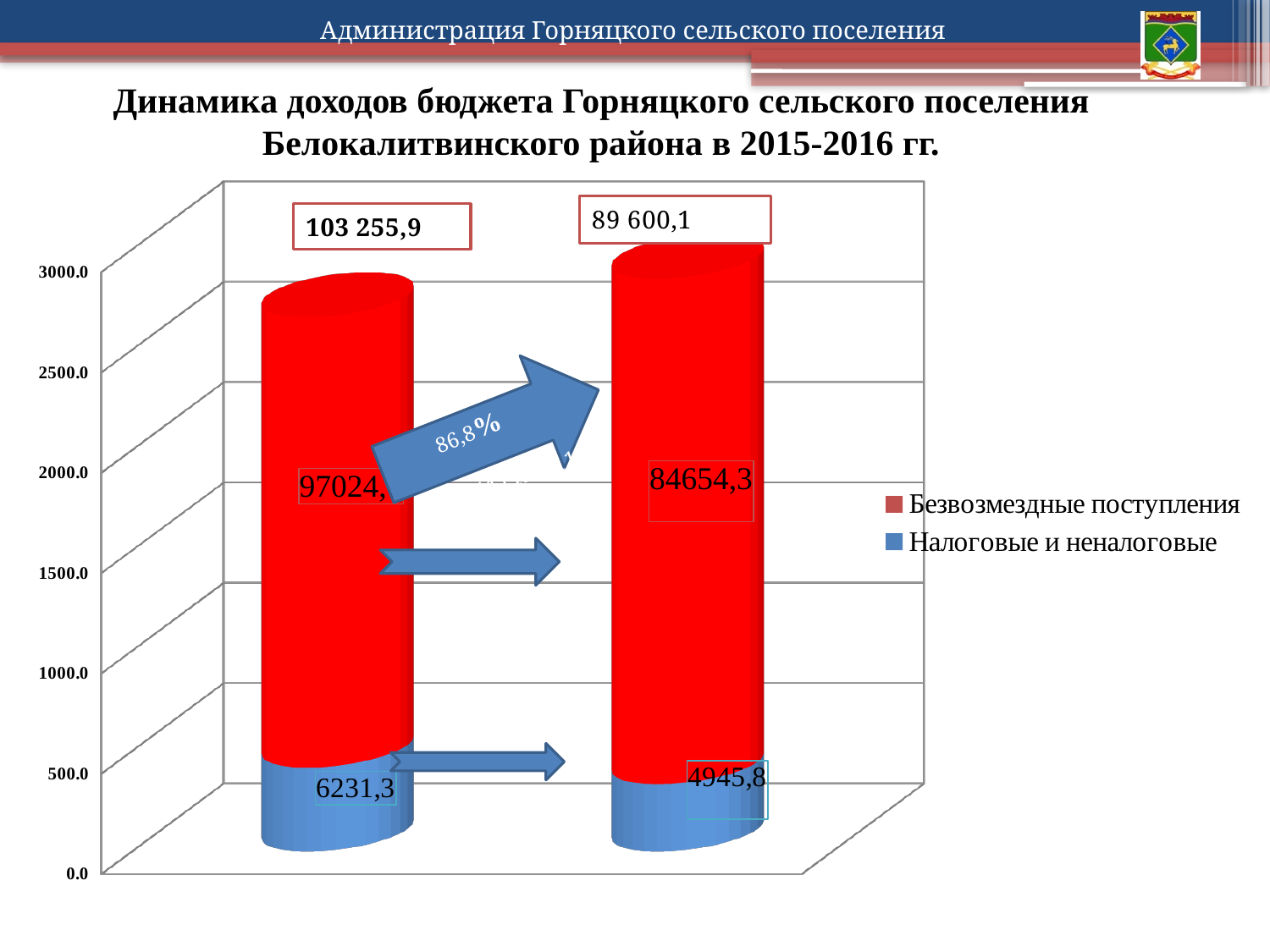
What is the value of Налоговые и неналоговые for the right bar? 4945,8 What is the value of Безвозмездные поступления for the right bar? 84654,3 Which bar has the larger Налоговые и неналоговые value, the left or the right? Left What total is shown above the left bar? 103 255,9 How many series does the legend list? 2 How many bars are plotted in the chart? 2 What is the difference between the Налоговые и неналоговые values of the left and right bars? 1285,5 What percentage is written on the large diagonal arrow between the bars? 86,8% What total is shown above the right bar? 89 600,1 What is the value of Налоговые и неналоговые for the left bar? 6231,3 What kind of chart is shown on the slide? Stacked bar chart